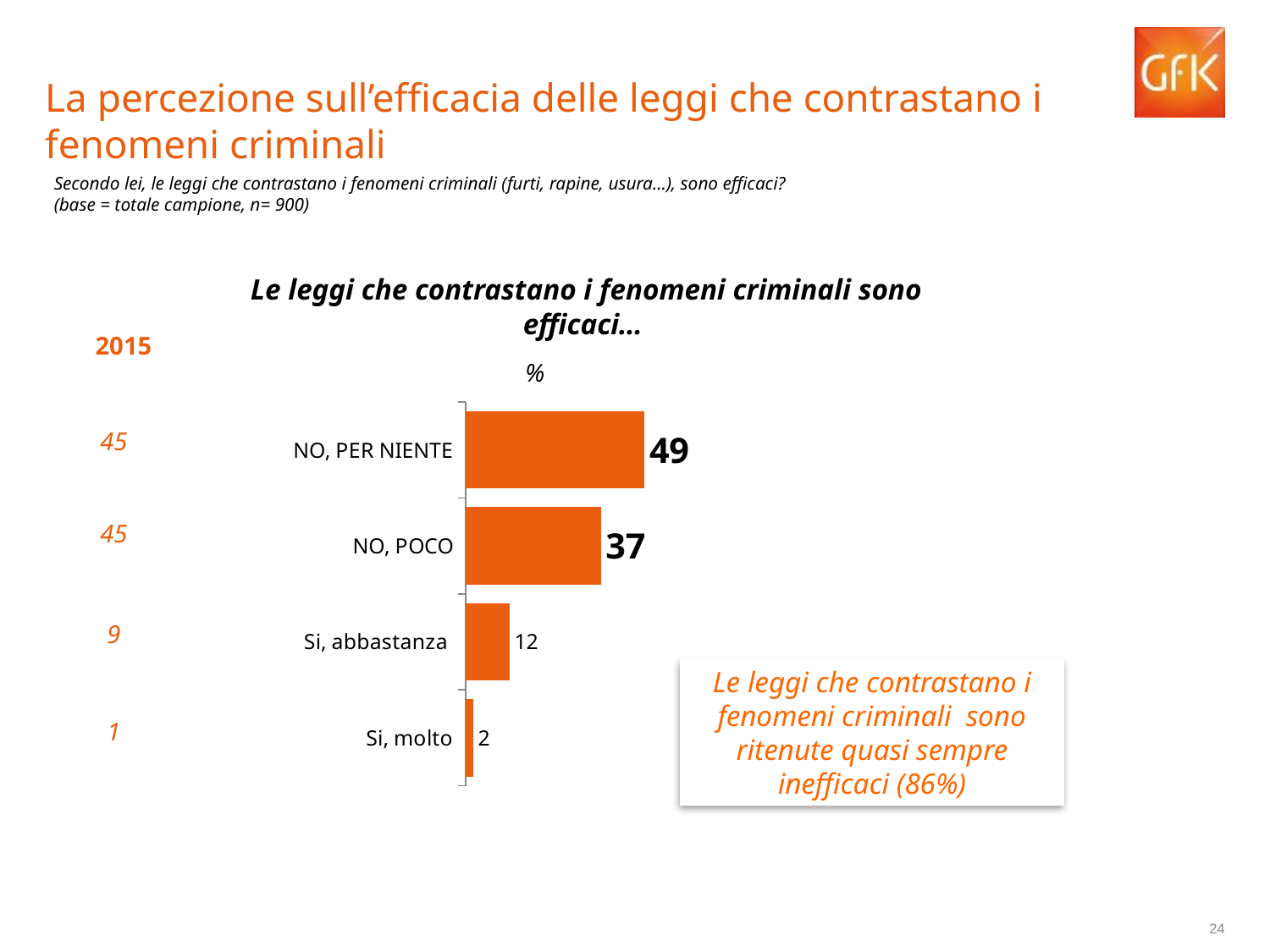
What is the combined value of NO, PER NIENTE and NO, POCO? 86 What is the value for Si, abbastanza? 12 What is the difference between the values for NO, PER NIENTE and NO, POCO? 12 Which is larger, the value for Si, abbastanza or the value for Si, molto? Si, abbastanza Which category has the highest value? NO, PER NIENTE What is the title of the chart? Le leggi che contrastano i fenomeni criminali sono efficaci… Which category has the lowest value? Si, molto What is the value for Si, molto? 2 How many categories are shown in the chart? 4 What is the value for NO, POCO? 37 What kind of chart is shown on the slide? Bar chart What is the value for NO, PER NIENTE? 49